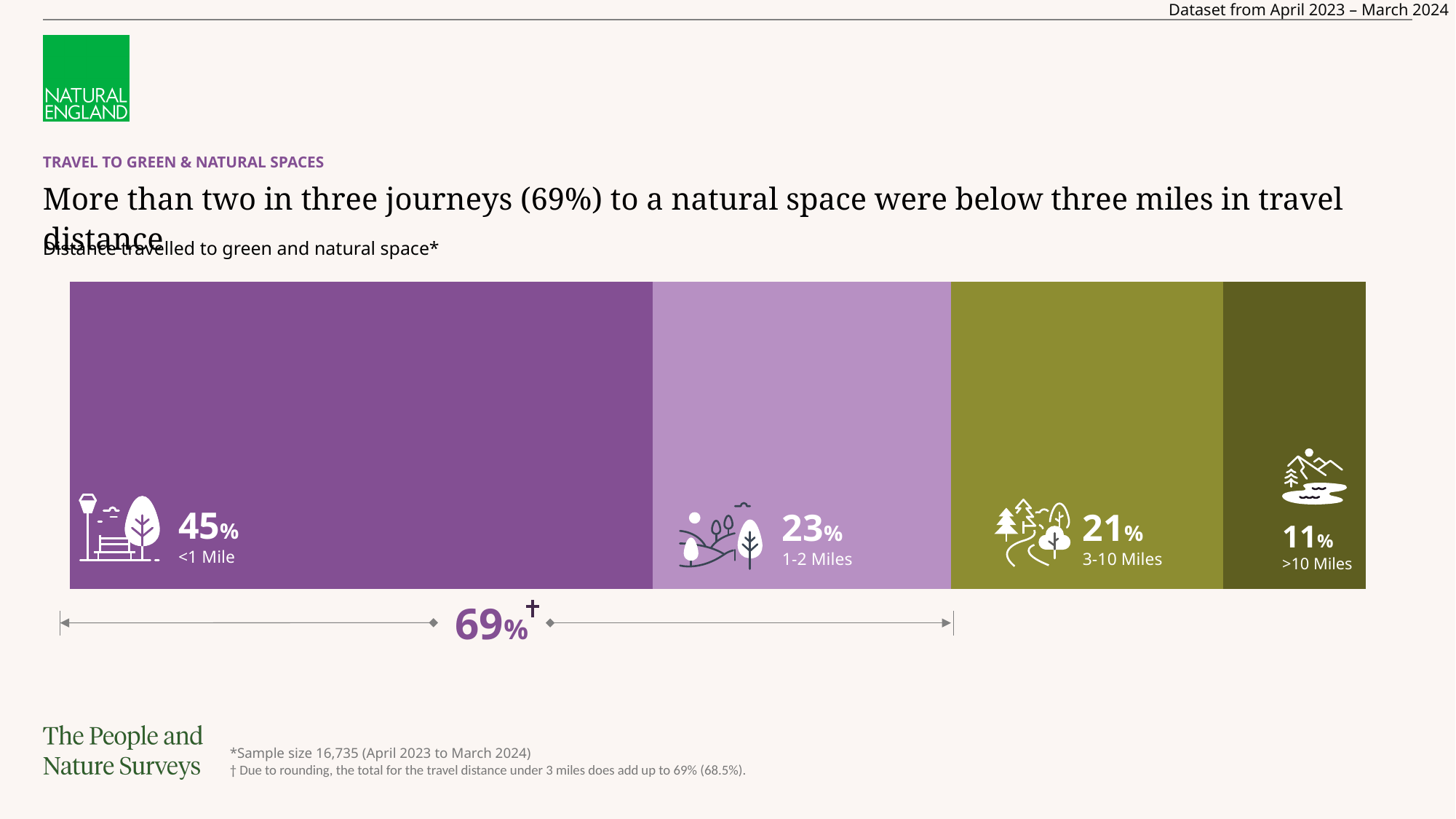
What is the title of the chart? Distance travelled to green and natural space* What percentage of journeys to green and natural space were less than 1 mile? 45% What percentage of journeys were more than 10 miles? 11% What percentage of journeys were 3-10 miles? 21% How many distance categories are shown in the bar? 4 What percentage of journeys were 1-2 miles? 23% Which distance category has the highest share of journeys? <1 Mile Which distance category has the lowest share of journeys? >10 Miles What kind of chart is used to show distance travelled to green and natural space? Stacked bar chart Which is larger, the share for 3-10 Miles or the share for >10 Miles? 3-10 Miles What combined percentage is shown for journeys under three miles (<1 Mile plus 1-2 Miles)? 69% What is the difference in percentage points between the <1 Mile and 1-2 Miles categories? 22